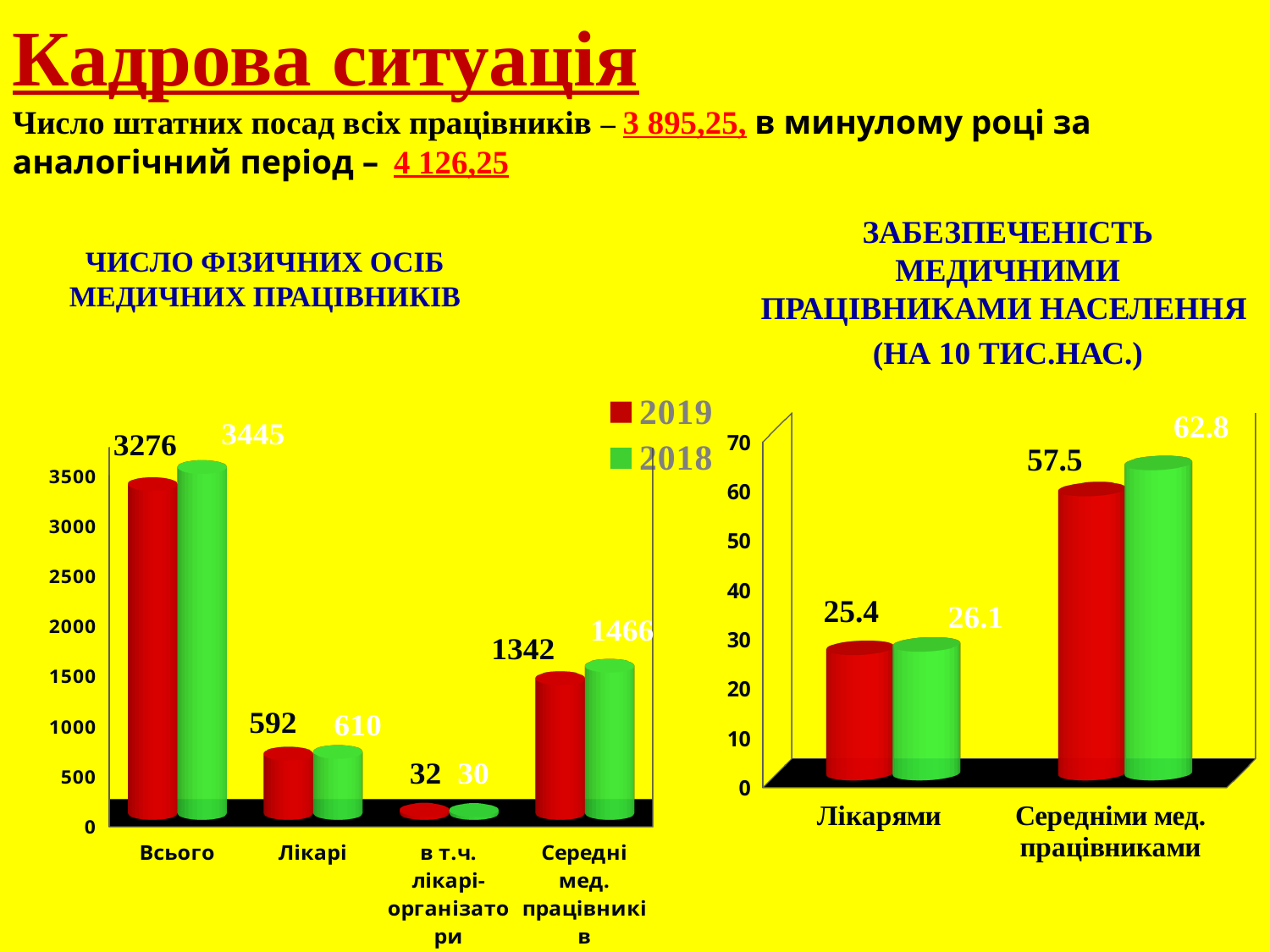
In the left chart (ЧИСЛО ФІЗИЧНИХ ОСІБ МЕДИЧНИХ ПРАЦІВНИКІВ), which category has the lowest 2019 value? в т.ч. лікарі-організатори In the right chart (ЗАБЕЗПЕЧЕНІСТЬ МЕДИЧНИМИ ПРАЦІВНИКАМИ НАСЕЛЕННЯ), what is the 2018 value for Середніми мед. працівниками? 62.8 In the right chart (ЗАБЕЗПЕЧЕНІСТЬ МЕДИЧНИМИ ПРАЦІВНИКАМИ НАСЕЛЕННЯ), what is the 2019 value for Лікарями? 25.4 In the left chart (ЧИСЛО ФІЗИЧНИХ ОСІБ МЕДИЧНИХ ПРАЦІВНИКІВ), what is the 2019 value for Всього? 3276 In the left chart (ЧИСЛО ФІЗИЧНИХ ОСІБ МЕДИЧНИХ ПРАЦІВНИКІВ), what is the difference between the 2018 and 2019 values for Всього? 169 In the left chart (ЧИСЛО ФІЗИЧНИХ ОСІБ МЕДИЧНИХ ПРАЦІВНИКІВ), how many categories are shown on the x axis? 4 What type of chart is the right chart (ЗАБЕЗПЕЧЕНІСТЬ МЕДИЧНИМИ ПРАЦІВНИКАМИ НАСЕЛЕННЯ)? bar chart In the left chart (ЧИСЛО ФІЗИЧНИХ ОСІБ МЕДИЧНИХ ПРАЦІВНИКІВ), which is larger for в т.ч. лікарі-організатори: the 2019 value or the 2018 value? 2019 In the left chart (ЧИСЛО ФІЗИЧНИХ ОСІБ МЕДИЧНИХ ПРАЦІВНИКІВ), what is the 2019 value for Середні мед. працівники? 1342 In the left chart (ЧИСЛО ФІЗИЧНИХ ОСІБ МЕДИЧНИХ ПРАЦІВНИКІВ), what is the 2018 value for Лікарі? 610 In the right chart (ЗАБЕЗПЕЧЕНІСТЬ МЕДИЧНИМИ ПРАЦІВНИКАМИ НАСЕЛЕННЯ), what is the difference between the 2018 and 2019 values for Середніми мед. працівниками? 5.3